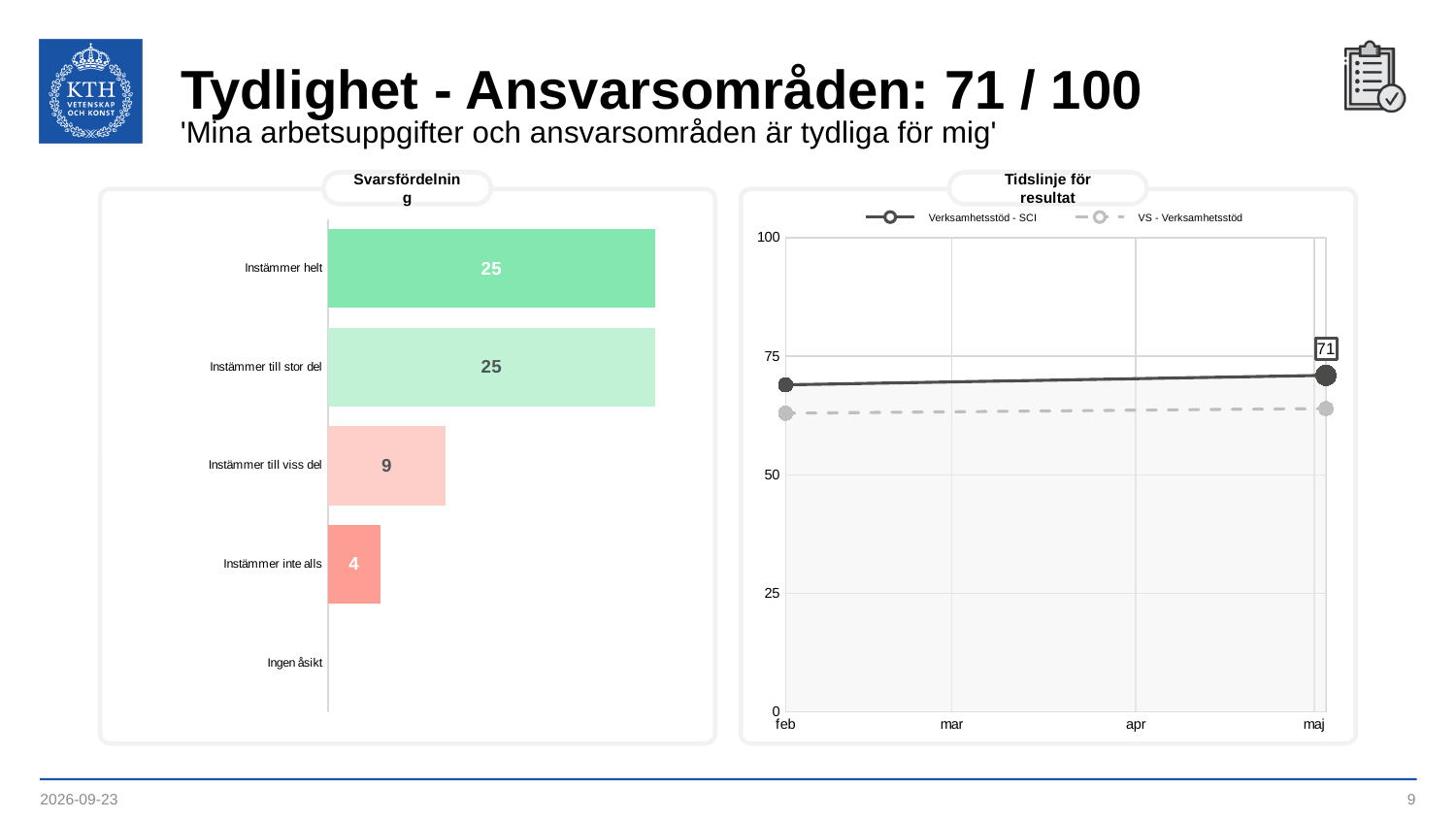
In the Tidslinje för resultat chart, which series is higher in maj: Verksamhetsstöd - SCI or VS - Verksamhetsstöd? Verksamhetsstöd - SCI In the Svarsfördelning chart, what is the value for 'Instämmer helt'? 25 In the Tidslinje för resultat chart, what is the value of Verksamhetsstöd - SCI in maj? 71 What kind of chart is the Tidslinje för resultat chart? Line chart In the Svarsfördelning chart, how many categories are listed on the axis? 5 In the Svarsfördelning chart, which is larger: 'Instämmer till stor del' or 'Instämmer till viss del'? Instämmer till stor del In the Tidslinje för resultat chart, how many series does the legend list? 2 In the Svarsfördelning chart, what is the value for 'Instämmer inte alls'? 4 What kind of chart is the Svarsfördelning chart? Bar chart In the Svarsfördelning chart, what is the difference between 'Instämmer till viss del' and 'Instämmer inte alls'? 5 In the Svarsfördelning chart, what is the value for 'Instämmer till viss del'? 9 In the Tidslinje för resultat chart, is the value of VS - Verksamhetsstöd in feb greater or less than 75? less